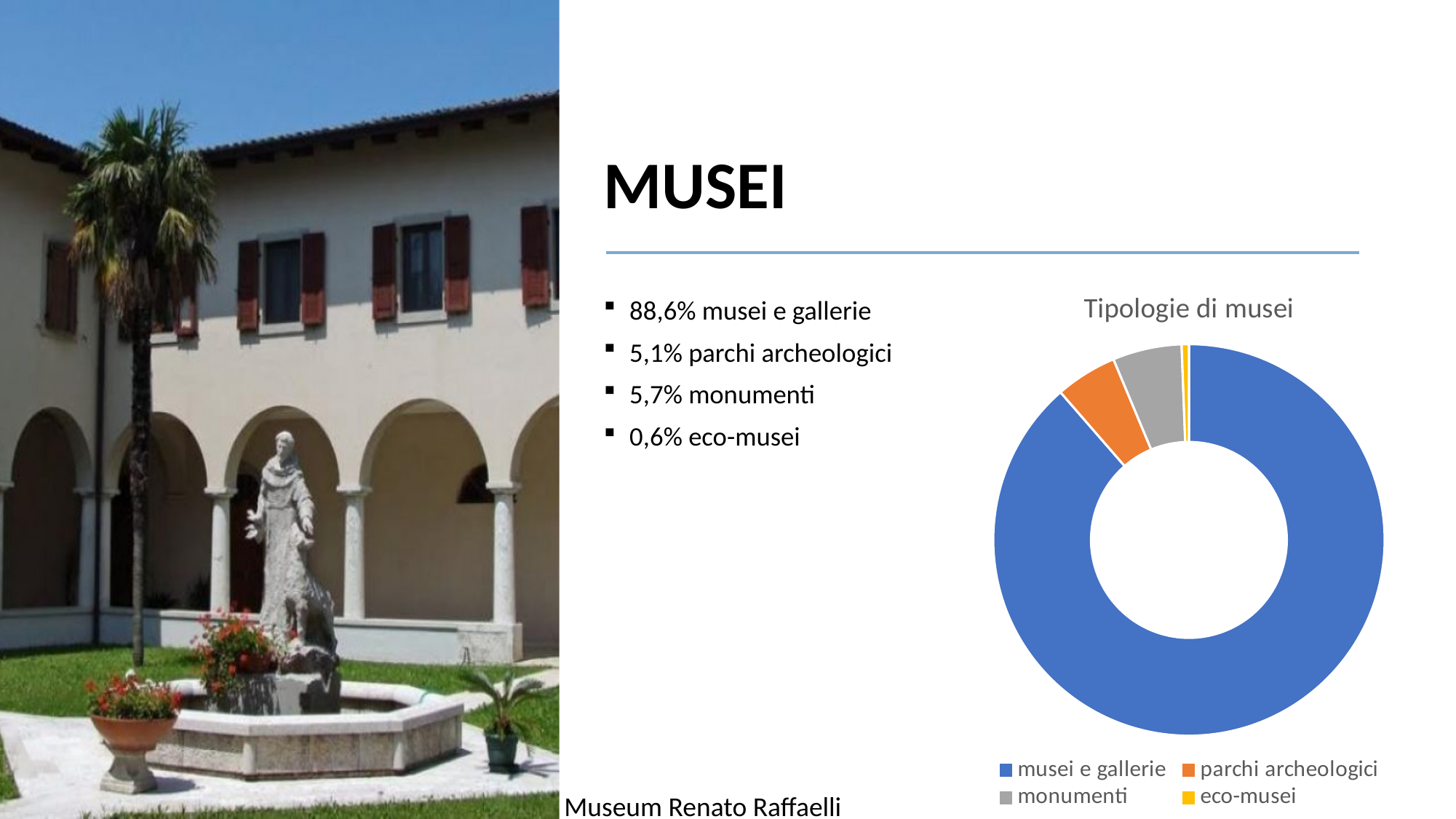
Which category has the smallest share of the chart? eco-musei What is the title of the chart on the slide? Tipologie di musei What share of the chart is musei e gallerie? 88,6% How many categories does the chart show? 4 What share of the chart is eco-musei? 0,6% Which is larger, the share for monumenti or the share for parchi archeologici? monumenti Which category has the largest share of the chart? musei e gallerie What share of the chart is parchi archeologici? 5,1% What is the difference between the share for musei e gallerie and the share for monumenti? 82,9% What colour is the musei e gallerie slice in the chart? blue What kind of chart is shown on the slide? doughnut chart